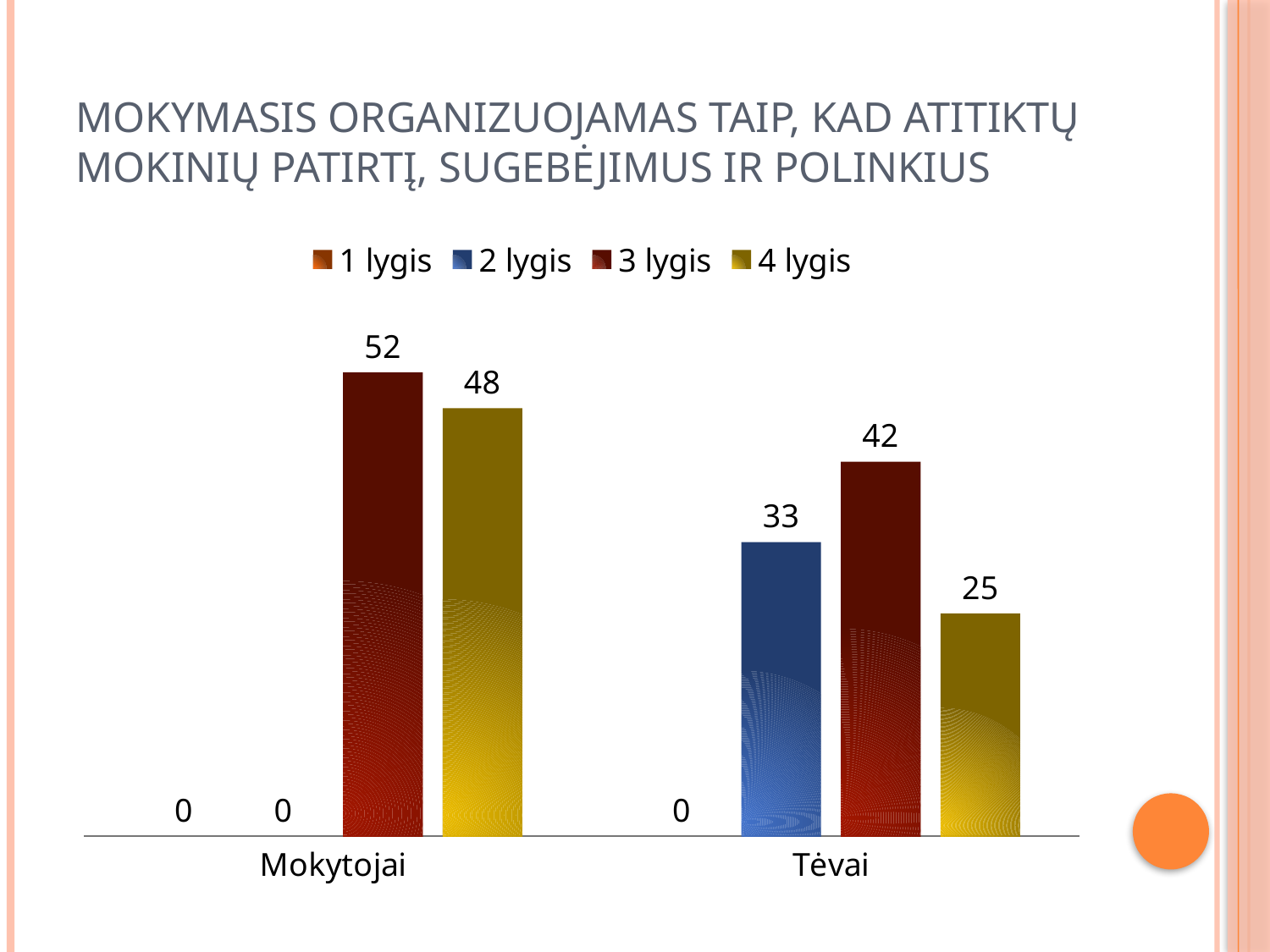
What is the difference between the 3 lygis values for Mokytojai and Tėvai? 10 How many categories are shown on the x axis? 2 What is the value for 4 lygis in the Tėvai category? 25 What kind of chart is shown on the slide? Bar chart How many series does the legend list? 4 What is the value for 4 lygis in the Mokytojai category? 48 Which is larger: the 4 lygis value for Mokytojai or the 4 lygis value for Tėvai? Mokytojai What is the value for 3 lygis in the Mokytojai category? 52 What is the value for 1 lygis in the Tėvai category? 0 What is the value for 2 lygis in the Tėvai category? 33 Which series has the lowest non-zero value in the Tėvai category? 4 lygis Which series has the highest value in the Tėvai category? 3 lygis